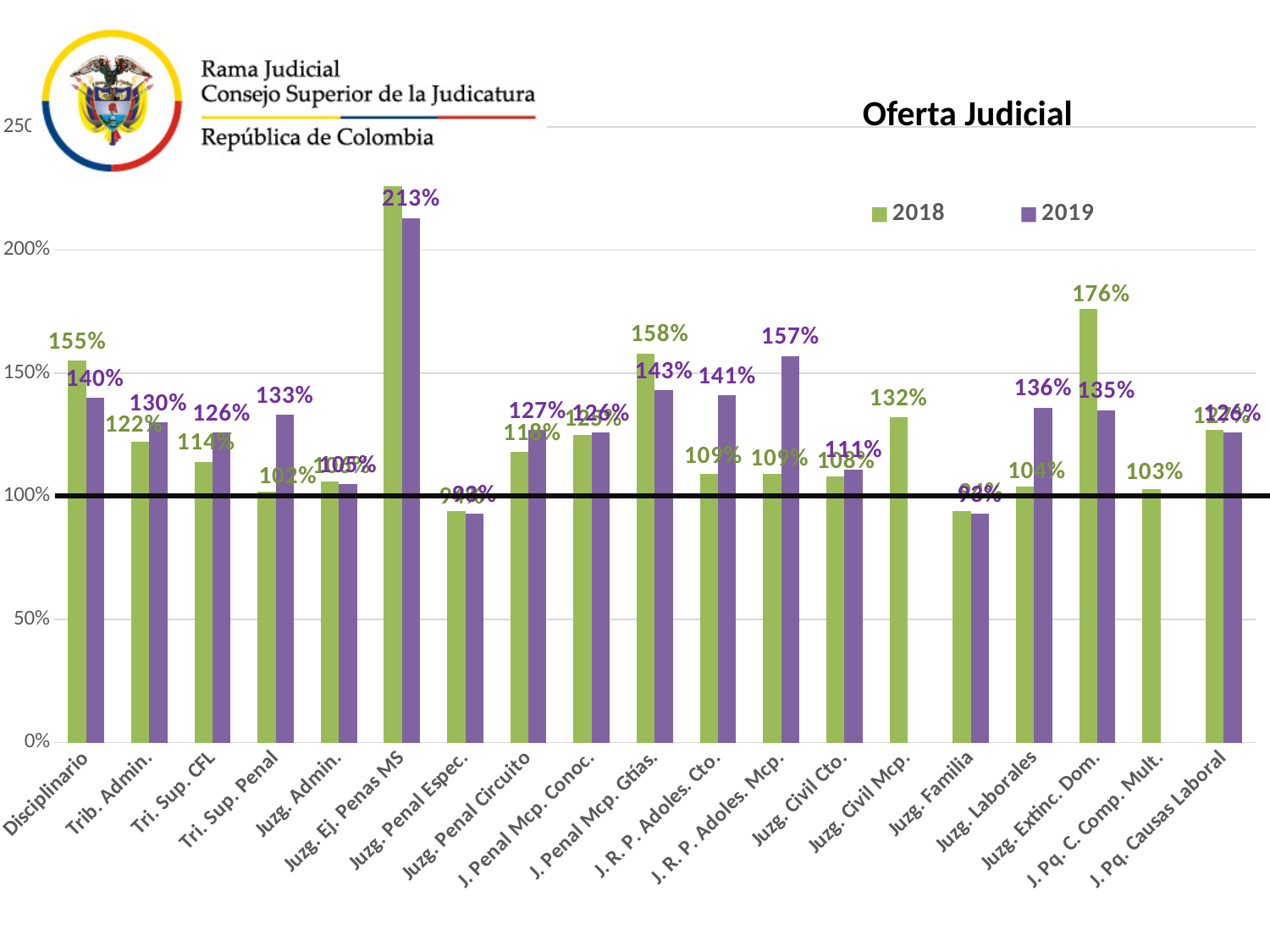
How many series does the legend list? 2 What is the 2019 value for J. R. P. Adoles. Mcp.? 157% What is the 2018 value for Juzg. Extinc. Dom.? 176% What is the difference between the 2018 and 2019 values for Disciplinario? 15 percentage points How many categories are shown along the x axis? 19 Which category has the highest 2019 value? Juzg. Ej. Penas MS What is the title of the chart? Oferta Judicial Is the 2018 value for Juzg. Ej. Penas MS greater or less than 200%? greater What is the 2019 value for Tri. Sup. Penal? 133% For Juzg. Laborales, which year has the larger value, 2018 or 2019? 2019 What is the 2018 value for Disciplinario? 155% What kind of chart is shown on the slide? Bar chart